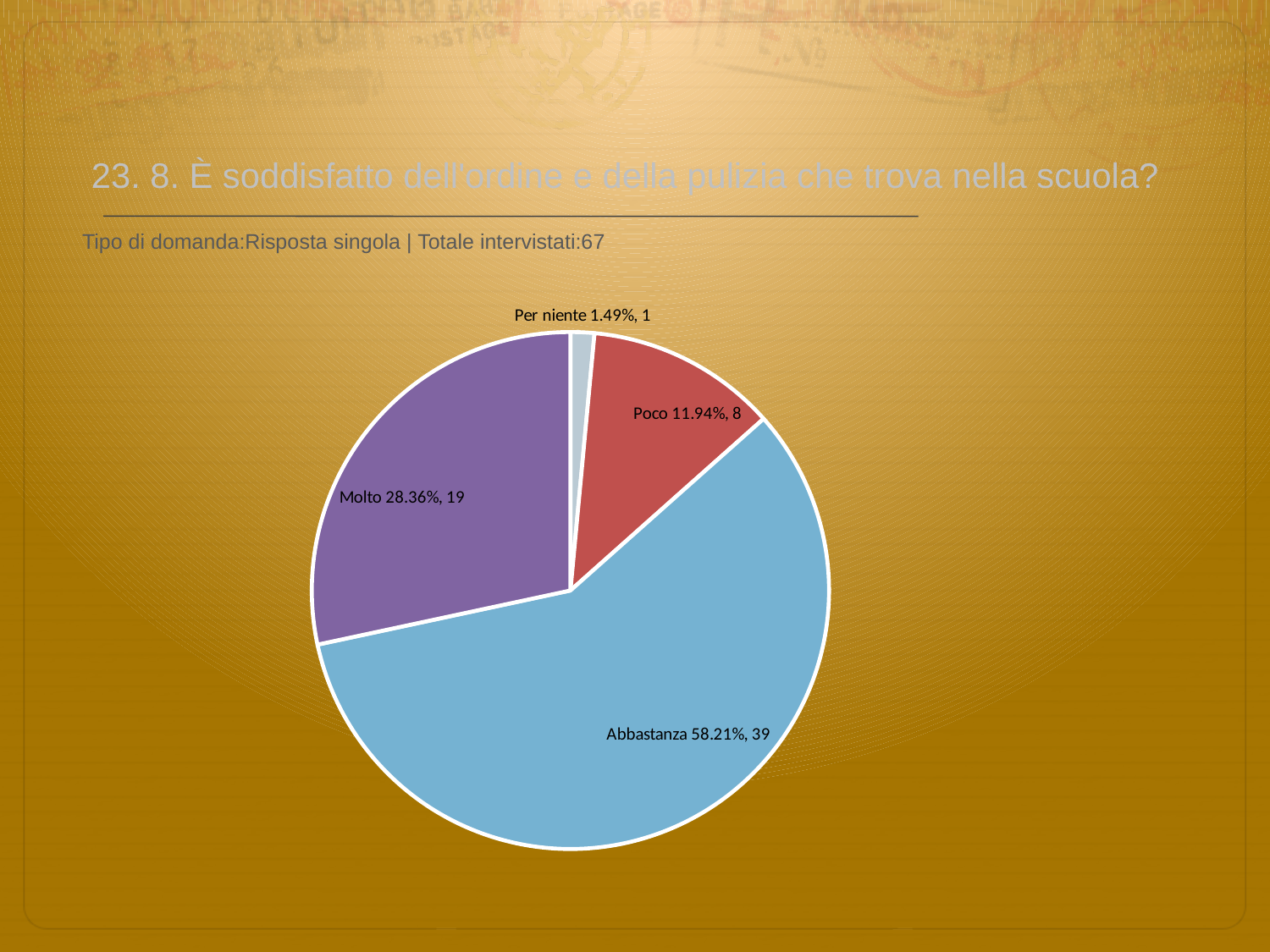
What is the difference in respondent count between Abbastanza and Molto? 20 Which has more respondents, Molto or Poco? Molto What percentage share does the Per niente slice have? 1.49% What colour is the Poco slice? red What is the total number of respondents across all slices? 67 How many respondents answered Molto? 19 How many slices does the pie chart have? 4 How many respondents answered Poco? 8 Which category has the largest slice? Abbastanza What percentage share does the Abbastanza slice have? 58.21% Which category has the smallest slice? Per niente What kind of chart is shown on the slide? pie chart